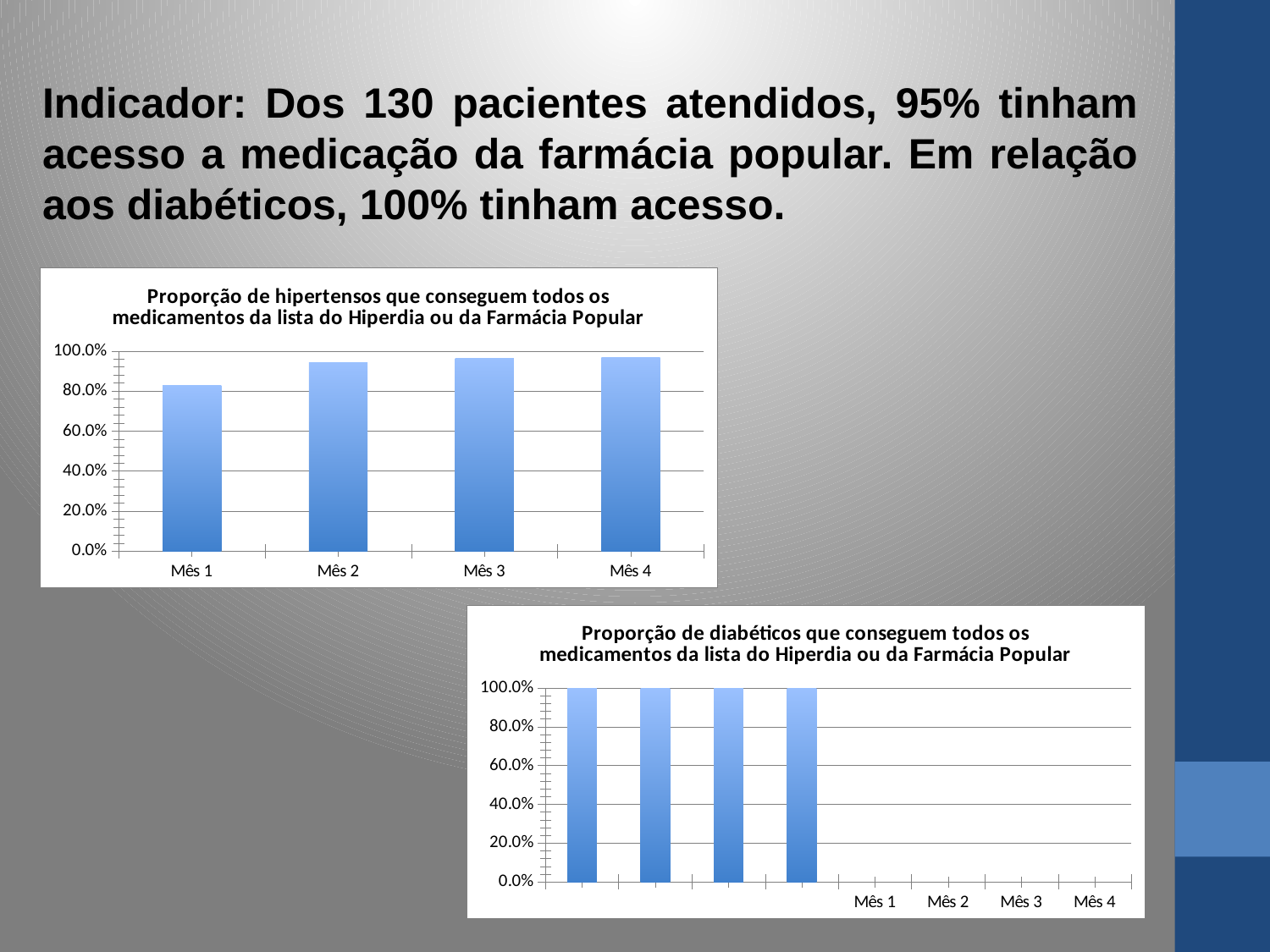
In the top chart about hipertensos, which is larger, the value for Mês 1 or the value for Mês 2? Mês 2 In the bottom chart about diabéticos, what is the proportion for Mês 1? 100.0% In the bottom chart about diabéticos, how many bars are plotted? 4 In the top chart about hipertensos, is the value for Mês 2 greater or less than 80.0%? greater In the top chart about hipertensos, is the value for Mês 4 greater or less than 100.0%? less In the top chart about hipertensos, is the value for Mês 1 greater or less than 60.0%? greater In the top chart about hipertensos, how many months are shown on the x axis? 4 In the top chart about hipertensos, do the values rise or fall from Mês 1 to Mês 4? Rise In the bottom chart about diabéticos, do the values rise, fall or stay the same across the months? Stay the same What is the highest value shown on the y axis of the bottom chart about diabéticos? 100.0% What kind of chart is the top chart, 'Proporção de hipertensos que conseguem todos os medicamentos da lista do Hiperdia ou da Farmácia Popular'? Bar chart In the top chart about hipertensos, which month has the lowest proportion? Mês 1